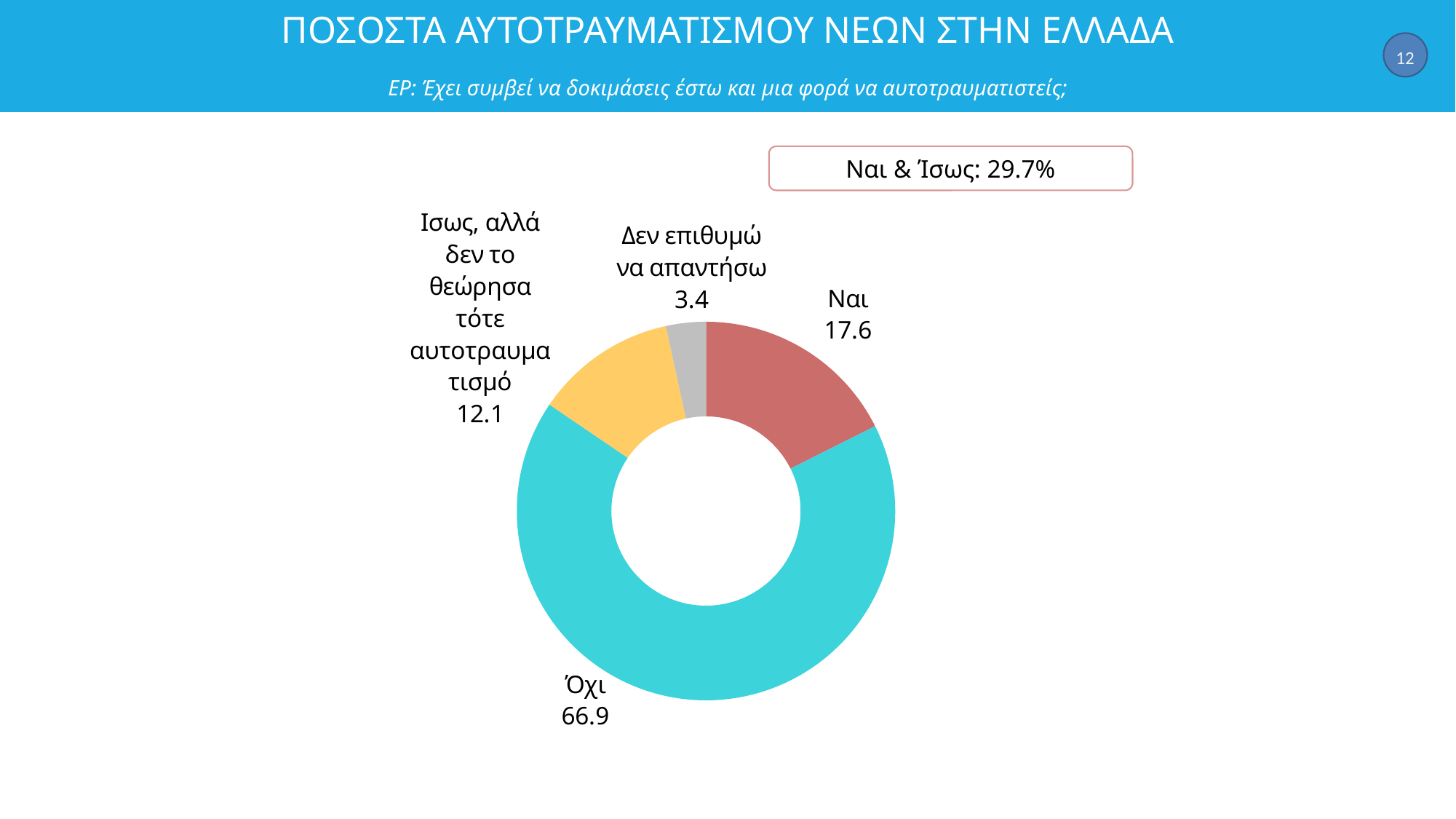
What is the value for the "Ίσως, αλλά δεν το θεώρησα τότε αυτοτραυματισμό" slice? 12.1 What is the value for the "Δεν επιθυμώ να απαντήσω" slice? 3.4 Which category has the smallest slice? Δεν επιθυμώ να απαντήσω What type of chart is shown on the slide? Doughnut (pie) chart What is the difference between the "Όχι" and "Ναι" values? 49.3 What combined percentage does the slide give for "Ναι & Ίσως"? 29.7% Which is larger, the "Ναι" slice or the "Ίσως, αλλά δεν το θεώρησα τότε αυτοτραυματισμό" slice? Ναι What is the title of the slide containing the chart? ΠΟΣΟΣΤΑ ΑΥΤΟΤΡΑΥΜΑΤΙΣΜΟΥ ΝΕΩΝ ΣΤΗΝ ΕΛΛΑΔΑ What is the value for the "Όχι" slice? 66.9 Which category has the largest slice? Όχι How many categories does the chart show? 4 What is the value for the "Ναι" slice? 17.6